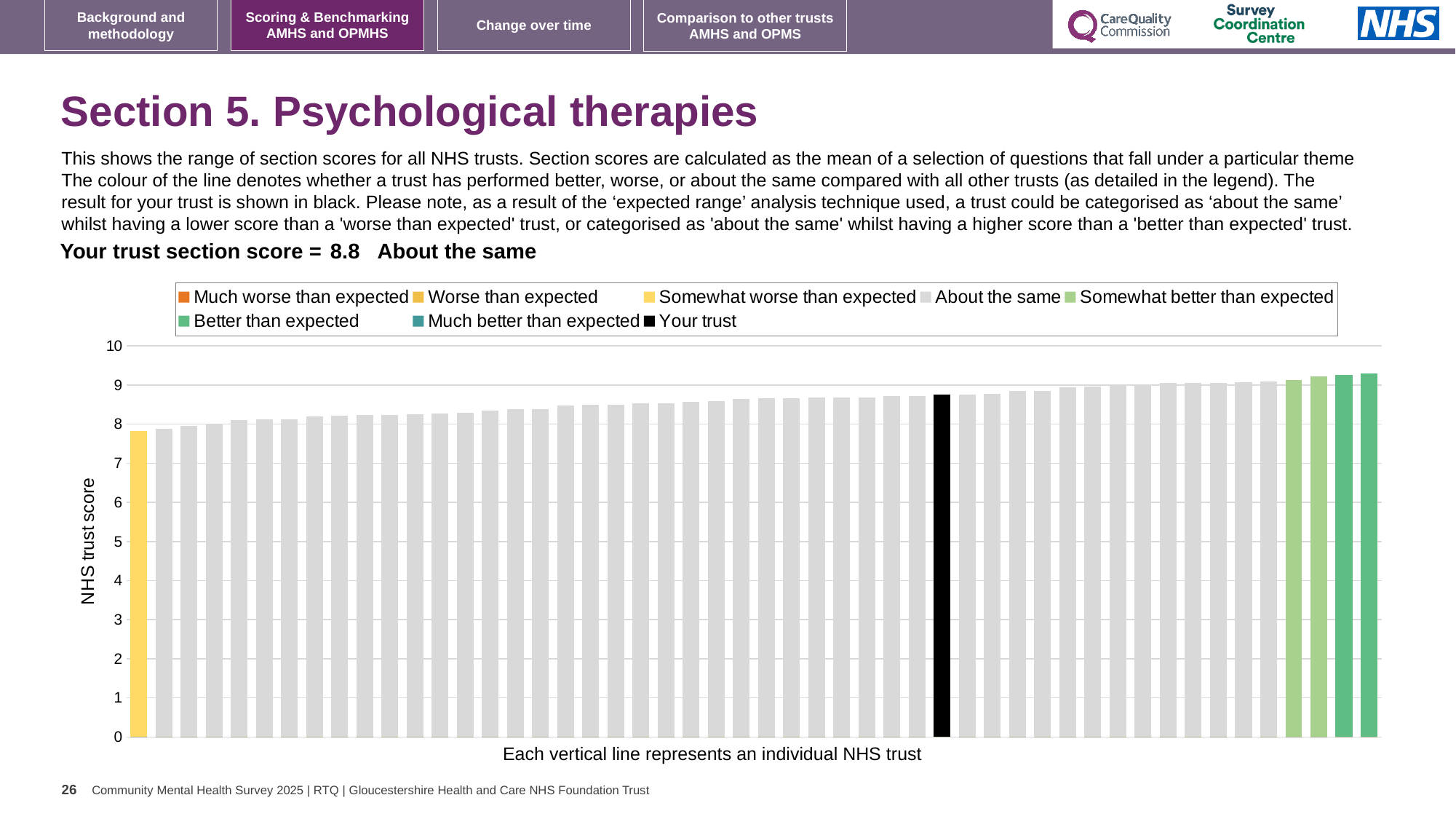
How many bars in the chart are coloured green? 4 How many bars in the chart are coloured black? 1 Is the value of the black bar (your trust) greater or less than 8? greater What does the label under the x axis say each vertical line represents? an individual NHS trust How many entries does the chart legend list? 8 What is the label on the vertical axis of the chart? NHS trust score Do the bar values rise or fall from left to right along the x axis? rise What kind of chart is shown on the slide? bar chart What is the section score for your trust shown on the slide? 8.8 Which category is your trust placed in for this section? About the same Is the value of the lowest bar greater or less than 9? less Is the value of the highest bar greater or less than 9? greater